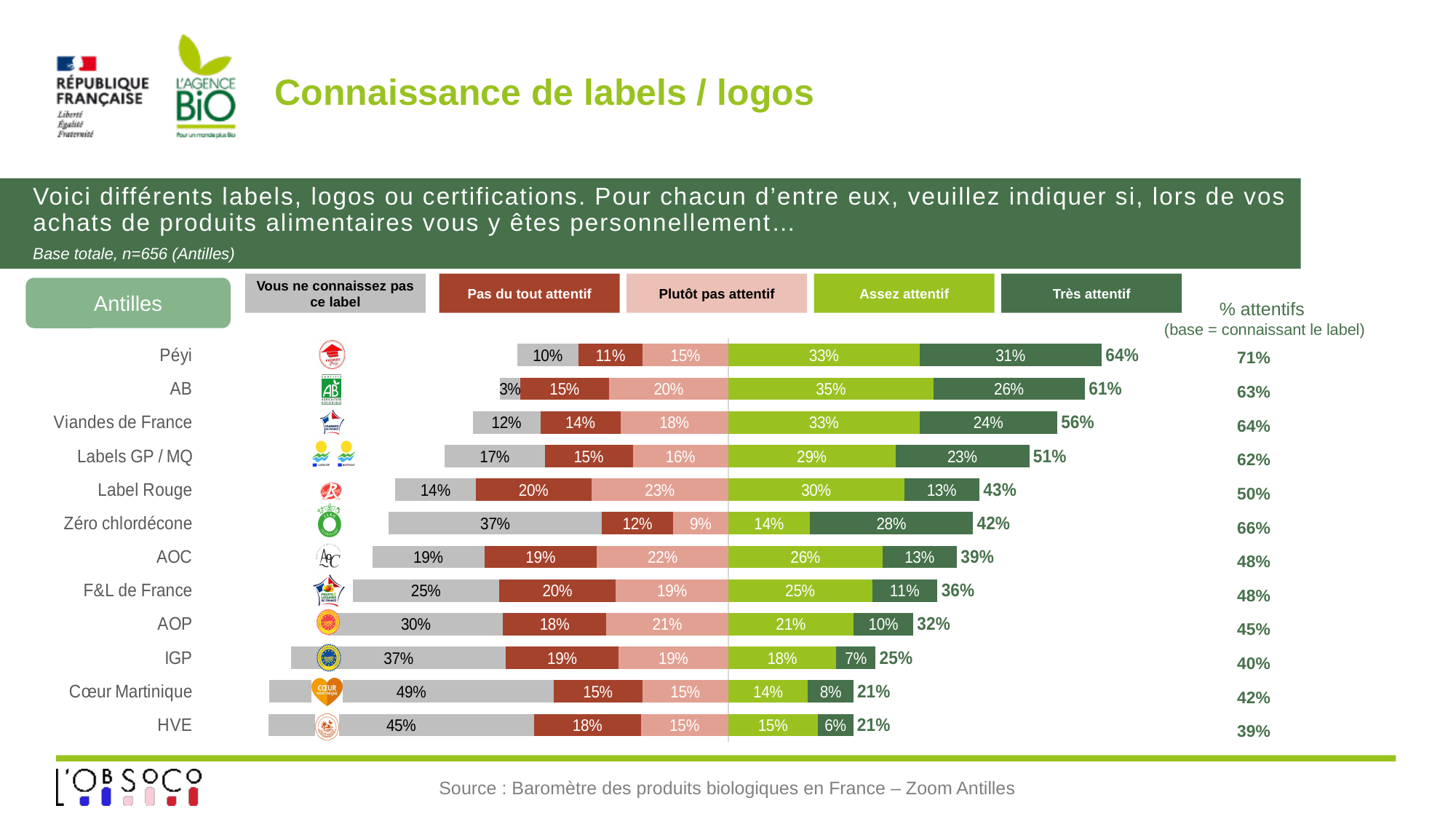
What kind of chart is shown on the slide? Stacked bar chart What colour represents the "Très attentif" category in the legend? Dark green How many response categories does the legend list? 5 What percentage of respondents are "Très attentif" to the Péyi label? 31% Which label has the highest combined attentive share (Assez attentif + Très attentif) shown at the end of its bar? Péyi What is the difference between the "Pas du tout attentif" values for Label Rouge and Péyi? 9% Which label has the lowest "Très attentif" percentage? HVE How many labels/logos are listed in the chart? 12 What is the "% attentifs" value (base = connaissant le label) for Zéro chlordécone? 66% Which has a larger "Plutôt pas attentif" share: Label Rouge or AOP? Label Rouge What percentage of respondents do not know the Cœur Martinique label ("Vous ne connaissez pas ce label")? 49% What is the "Assez attentif" value for the AB label? 35%